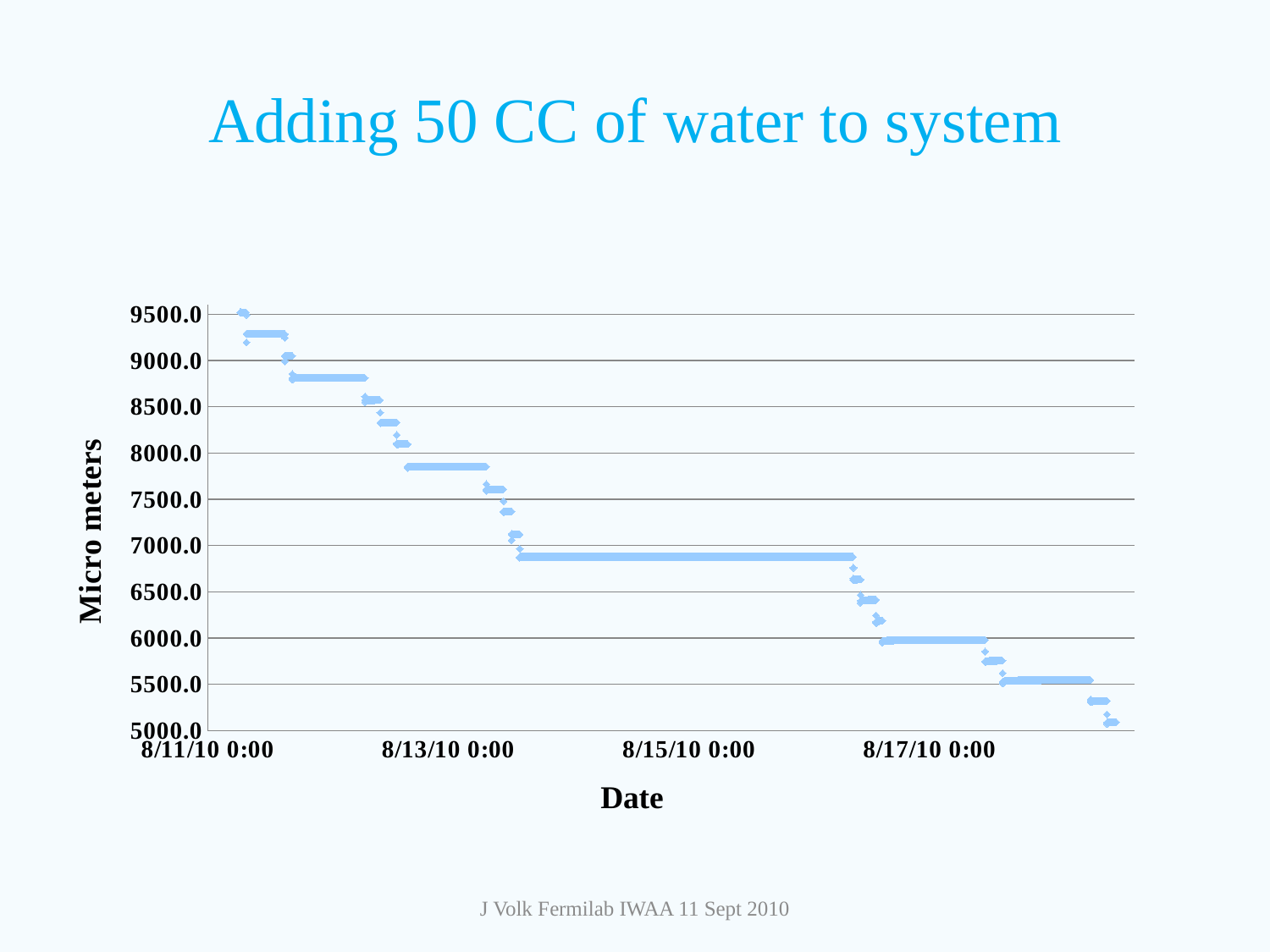
Is the first plotted value, near 8/11/10 0:00, greater or less than 9000? greater Do the plotted values rise or fall as the date increases along the x axis? fall Is the last plotted value, at the right end of the chart, greater or less than 5500? less What kind of chart is shown on the slide? scatter chart Is the value plotted at 8/13/10 0:00 greater or less than 7500? greater Is the highest plotted value at the beginning or the end of the date range? beginning What is the title of the chart? Adding 50 CC of water to system What is the label of the y axis? Micro meters How many date labels are shown on the x axis? 4